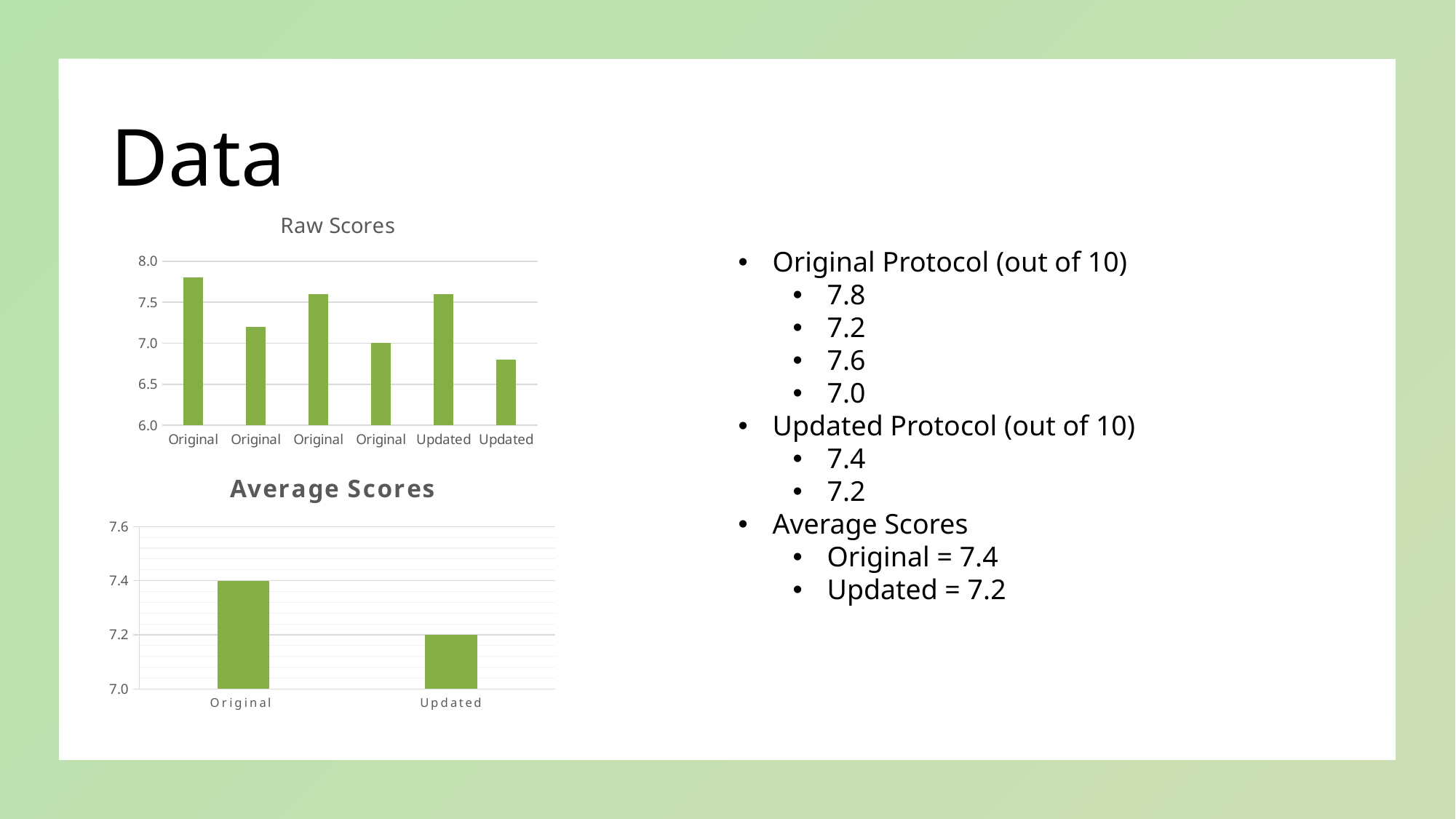
In the Raw Scores chart, how many bars are plotted? 6 What is the title of the lower chart on the slide? Average Scores In the Average Scores chart, which category has the higher value, Original or Updated? Original In the Average Scores chart, what is the value for Original? 7.4 In the Average Scores chart, what is the difference between the Original and Updated values? 0.2 In the Raw Scores chart, is the value of the first Original bar greater or less than 7.5? greater In the Raw Scores chart, is the value of the last Updated bar greater or less than 7.0? less What kind of chart is the Raw Scores chart? Bar chart In the Raw Scores chart, which bar is the highest? The first Original bar In the Average Scores chart, what is the value for Updated? 7.2 In the Raw Scores chart, which bar is the lowest? The last Updated bar In the Average Scores chart, how many categories are shown? 2